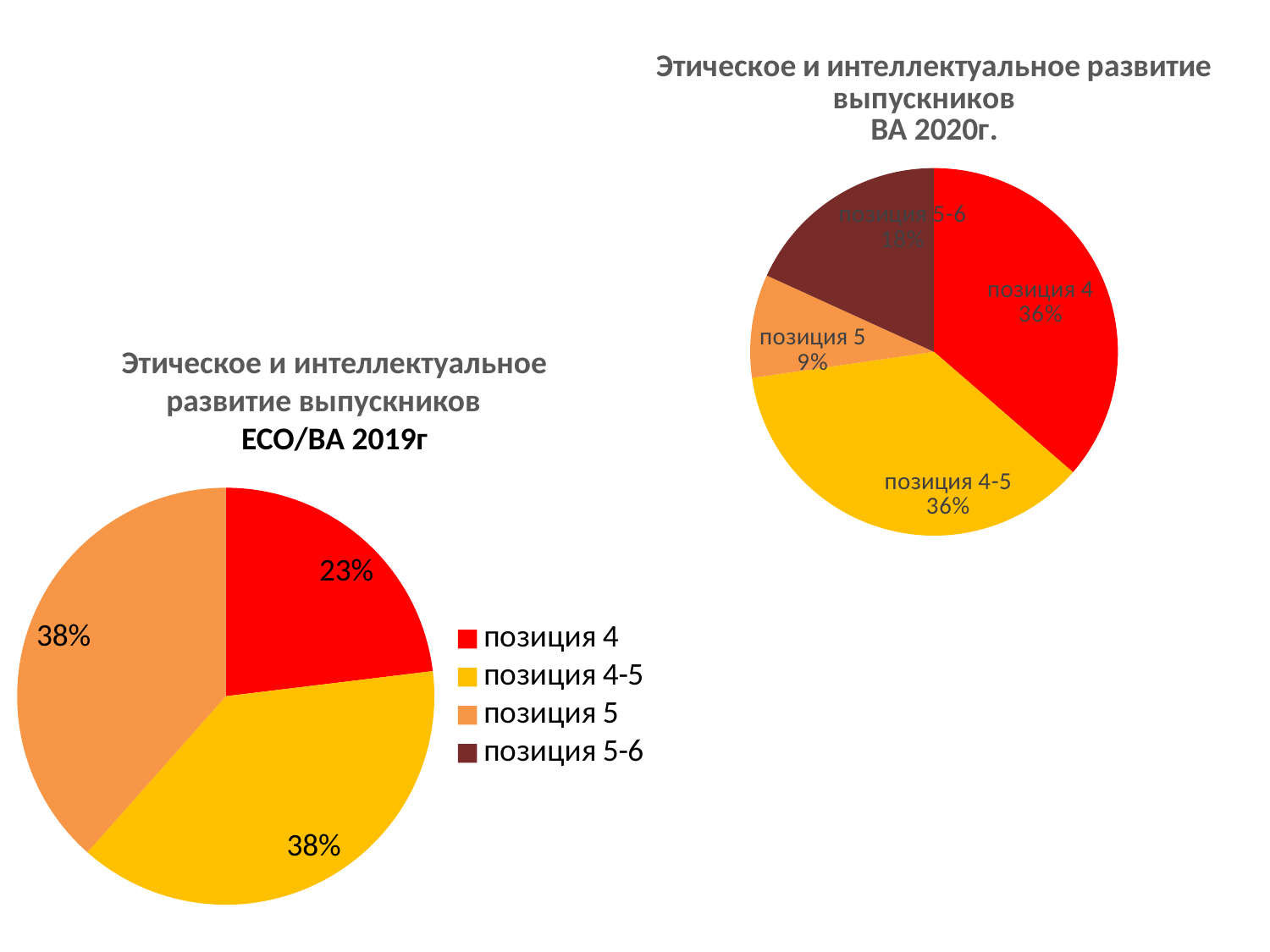
In the ВА 2020 chart, what share does позиция 5-6 have? 18% In the ВА 2020 chart, which category has the smallest slice? позиция 5 In the ECO/BA 2019 chart, what share does позиция 4-5 have? 38% In the ВА 2020 chart, what share does позиция 5 have? 9% In the ECO/BA 2019 chart, what share does позиция 4 have? 23% In the ECO/BA 2019 chart, which category has the smallest slice? позиция 4 In the ВА 2020 chart, what share does позиция 4 have? 36% What type of chart is used on this slide? Pie chart In the ВА 2020 chart, which is larger: the share of позиция 4 or the share of позиция 5-6? позиция 4 In the ECO/BA 2019 chart, what is the difference between the shares of позиция 5 and позиция 4? 15% In the ВА 2020 chart, what is the difference between the shares of позиция 5-6 and позиция 5? 9% How many entries does the legend on the slide list? 4